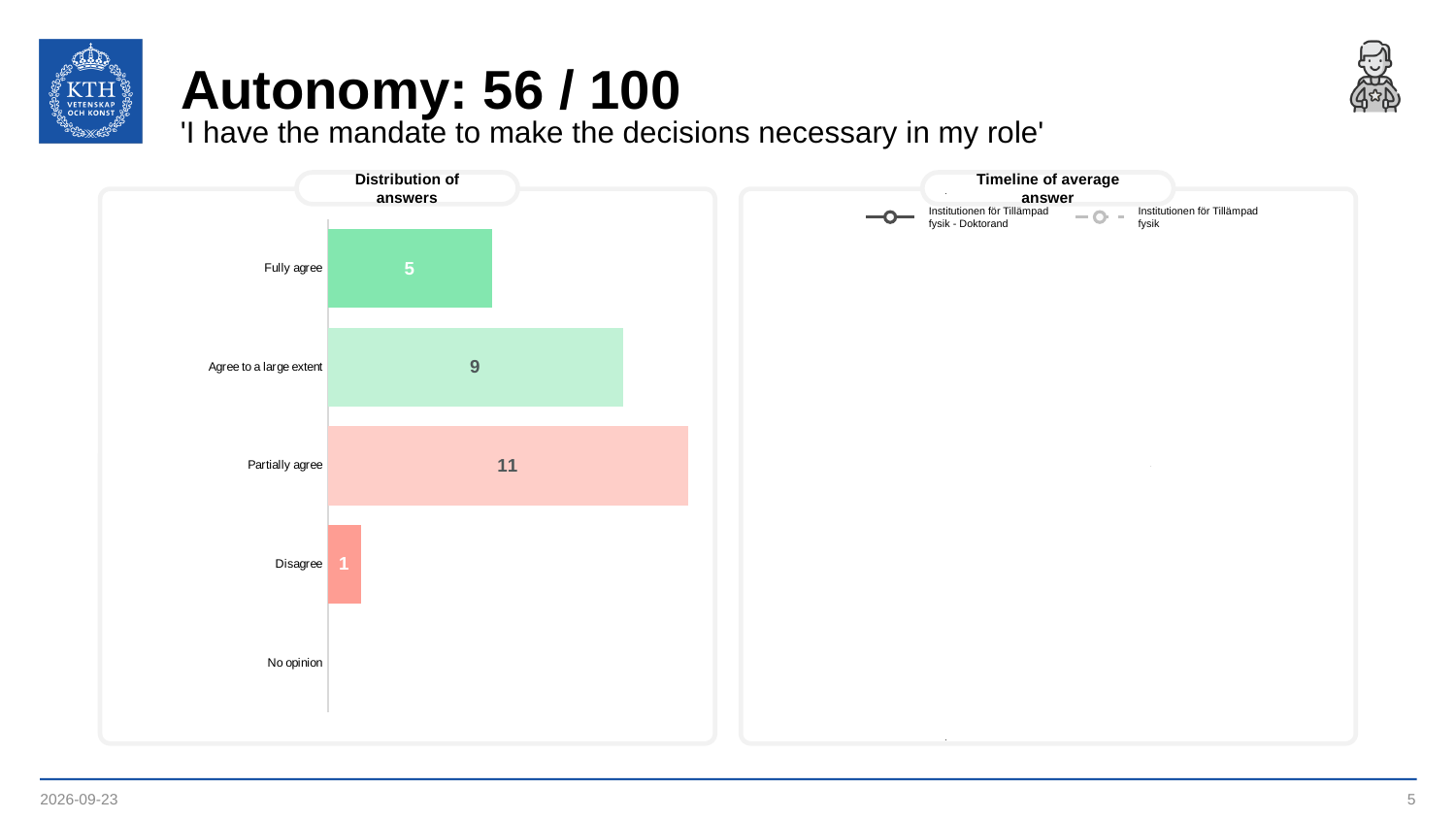
How many answer categories are listed on the y axis of the 'Distribution of answers' chart? 5 In the 'Distribution of answers' chart, which labelled bar has the lowest value? Disagree In the 'Distribution of answers' chart, which answer category has the highest value? Partially agree In the 'Distribution of answers' chart, which is larger: 'Agree to a large extent' or 'Fully agree'? Agree to a large extent What kind of chart is the 'Distribution of answers' chart? Bar chart How many series does the legend of the 'Timeline of average answer' chart list? 2 What is the title of the chart on the left side of the slide? Distribution of answers In the 'Distribution of answers' chart, what is the value for 'Agree to a large extent'? 9 In the 'Distribution of answers' chart, what is the difference between 'Partially agree' and 'Fully agree'? 6 In the 'Distribution of answers' chart, what is the value for 'Fully agree'? 5 In the 'Distribution of answers' chart, how many respondents chose 'Partially agree'? 11 In the 'Distribution of answers' chart, what is the value for 'Disagree'? 1